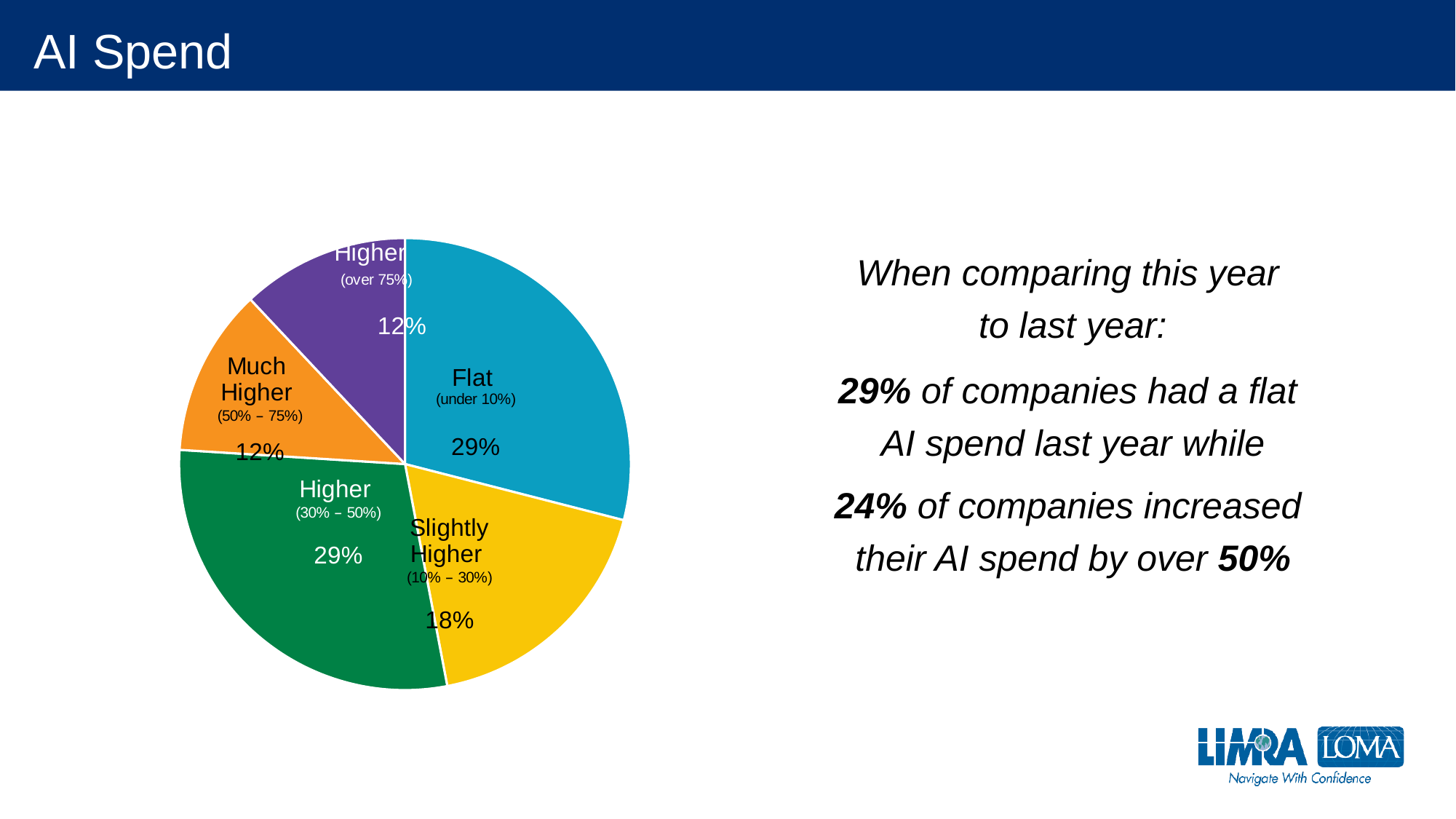
Which is larger, the Higher (30% – 50%) slice or the Much Higher (50% – 75%) slice? Higher (30% – 50%) What percentage of companies had a Flat (under 10%) AI spend? 29% What percentage is shown for the Higher (30% – 50%) slice? 29% What percentage is shown for the Much Higher (50% – 75%) slice? 12% What is the difference in percentage points between the Flat (under 10%) slice and the Slightly Higher (10% – 30%) slice? 11 percentage points How many slices does the pie chart have? 5 What kind of chart is shown on the slide? pie chart What percentage is shown for the Higher (over 75%) slice? 12% What is the combined share of the Much Higher (50% – 75%) and Higher (over 75%) slices? 24% What percentage is shown for the Slightly Higher (10% – 30%) slice? 18% What is the title of the slide containing the pie chart? AI Spend Which is larger, the Flat (under 10%) slice or the Slightly Higher (10% – 30%) slice? Flat (under 10%)